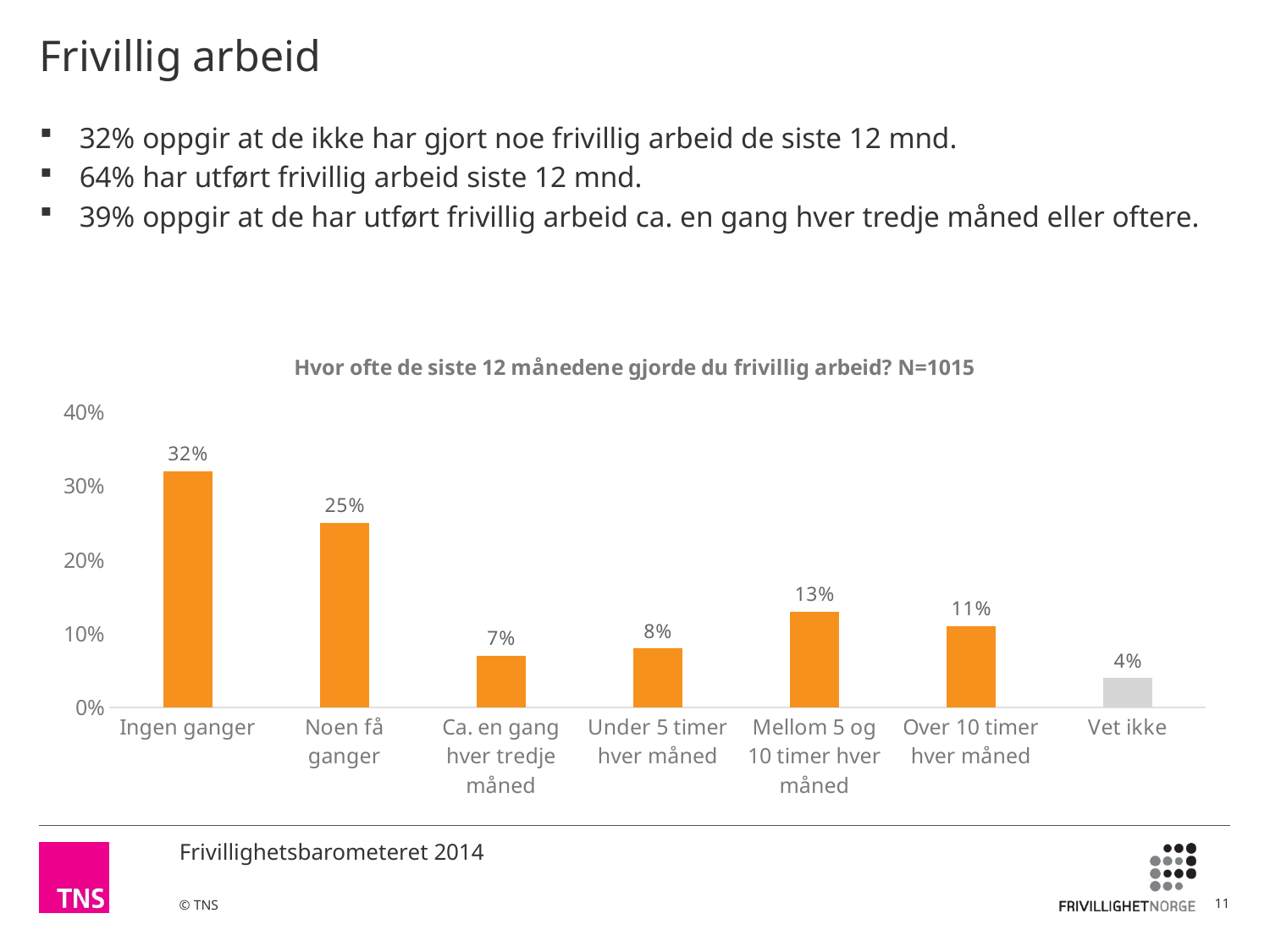
How many categories are shown on the x axis? 7 What is the value for "Vet ikke"? 4% Which is larger, the value for "Under 5 timer hver måned" or "Over 10 timer hver måned"? Over 10 timer hver måned What is the difference between the values for "Mellom 5 og 10 timer hver måned" and "Ca. en gang hver tredje måned"? 6% Which category has the lowest value? Vet ikke Which category has the highest value? Ingen ganger What is the value for "Ingen ganger"? 32% What is the difference between the values for "Ingen ganger" and "Noen få ganger"? 7% Is the value for "Noen få ganger" greater or less than 20%? greater What kind of chart is shown on the slide? bar chart What is the title of the chart? Hvor ofte de siste 12 månedene gjorde du frivillig arbeid? N=1015 What is the value for "Mellom 5 og 10 timer hver måned"? 13%